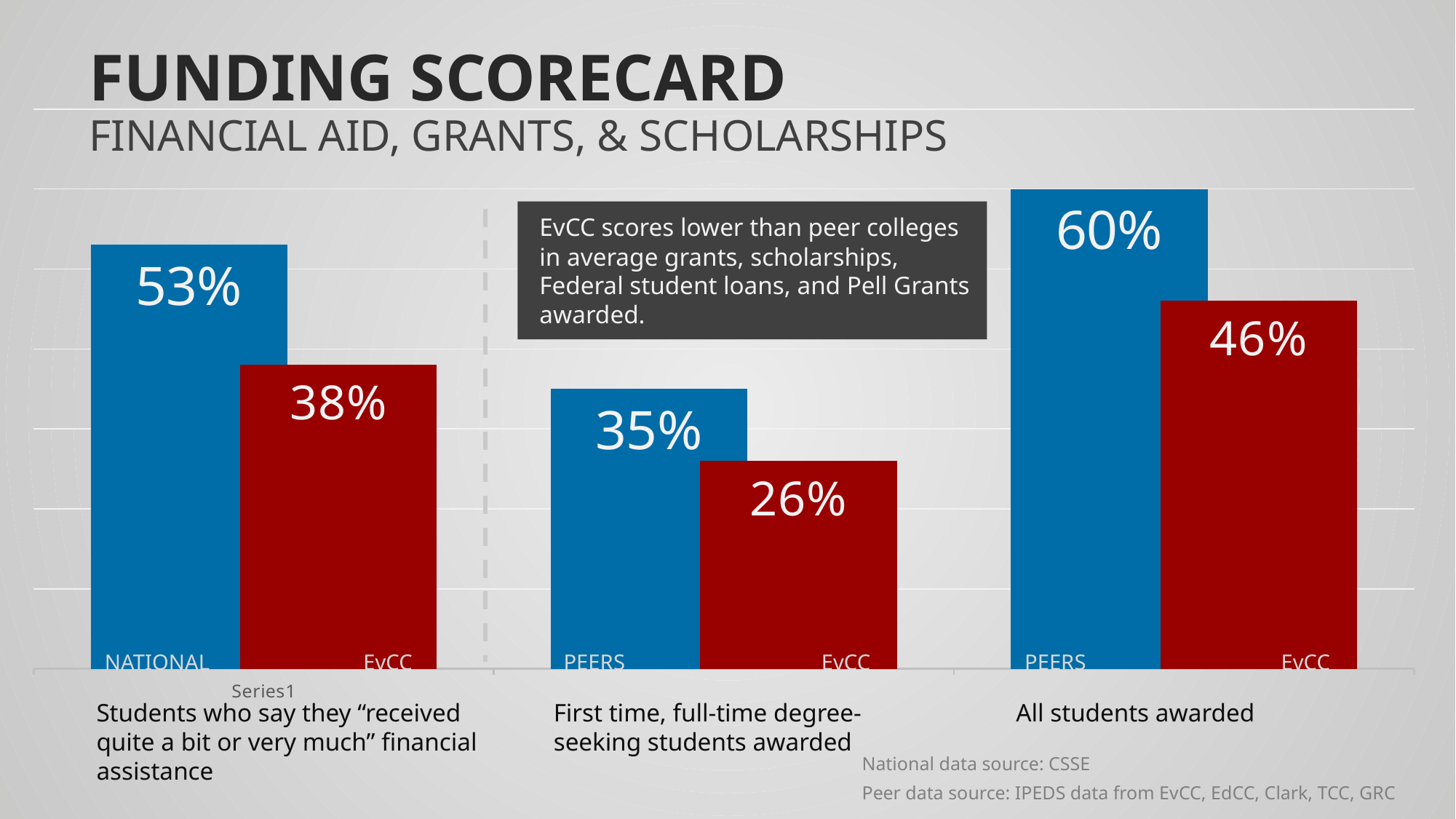
In the "All students awarded" group, what is the value for EvCC? 46% In the "First time, full-time degree-seeking students awarded" group, what is the difference between PEERS and EvCC? 9% In the "All students awarded" group, what is the value for PEERS? 60% In the "First time, full-time degree-seeking students awarded" group, what is the value for EvCC? 26% Across all bars on the slide, which bar has the lowest value? EvCC in "First time, full-time degree-seeking students awarded" (26%) Across all bars on the slide, which bar has the highest value? PEERS in "All students awarded" (60%) In the "Students who say they received quite a bit or very much financial assistance" group, what is the value for NATIONAL? 53% What kind of chart is shown on the slide? Bar chart What colour are the EvCC bars? Red In the "All students awarded" group, what is the difference between PEERS and EvCC? 14% In the "Students who say they received quite a bit or very much financial assistance" group, what is the value for EvCC? 38% In the "Students who say they received quite a bit or very much financial assistance" group, which is larger, NATIONAL or EvCC? NATIONAL